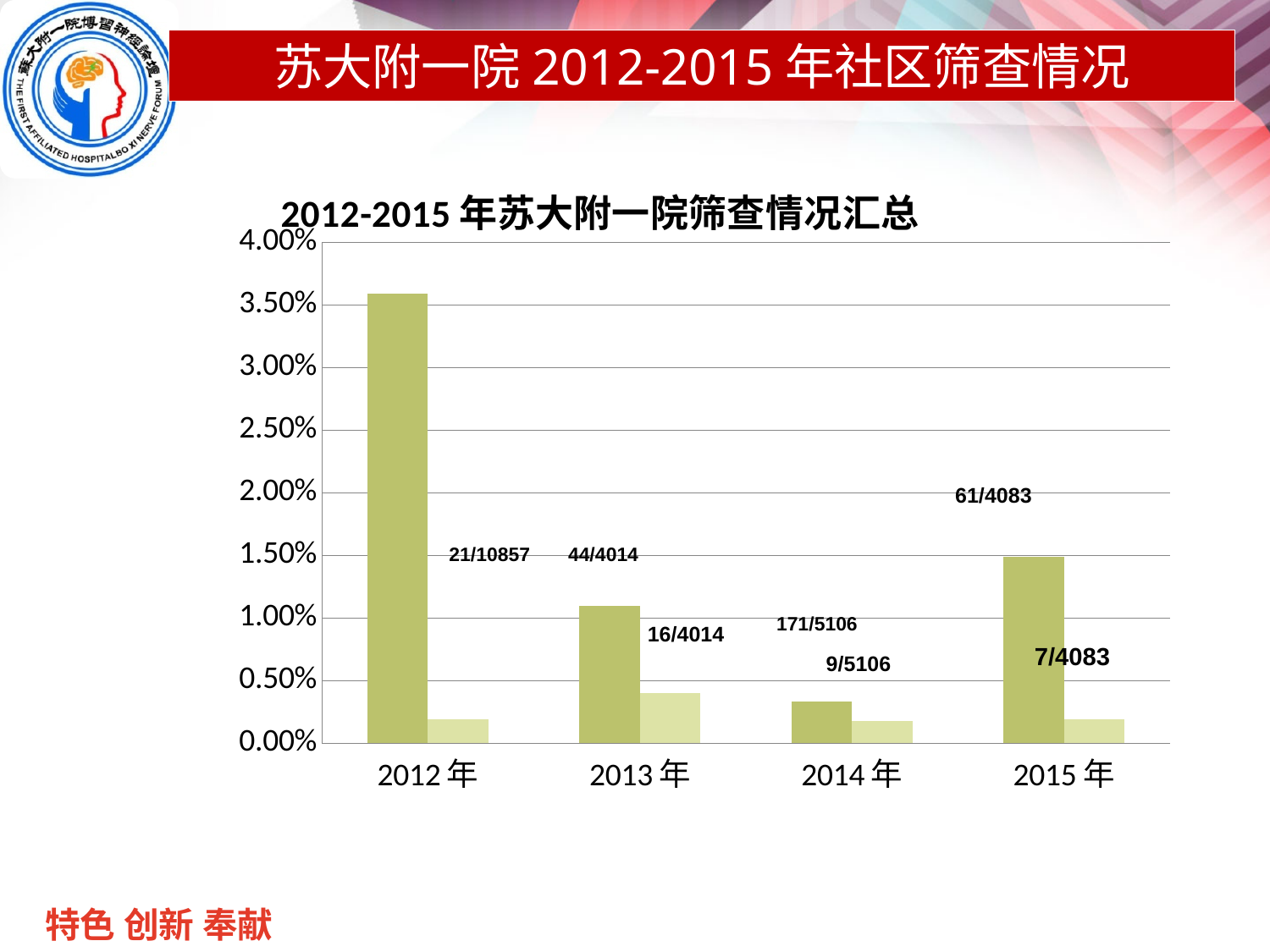
Is the darker green bar for 2015年 greater or less than 1.00%? greater Which year has the tallest lighter green bar? 2013年 Which year has the tallest darker green bar? 2012年 Is the darker green bar for 2013年 greater or less than 1.50%? less Do the darker green bars rise or fall from 2012年 to 2014年? fall Is the darker green bar for 2014年 greater or less than 0.50%? less Which darker green bar is taller, 2013年 or 2015年? 2015年 How many year categories are shown on the x axis of the chart? 4 What kind of chart is shown on the slide? bar chart What is the title of the chart? 2012-2015年苏大附一院筛查情况汇总 Which year has the shortest darker green bar? 2014年